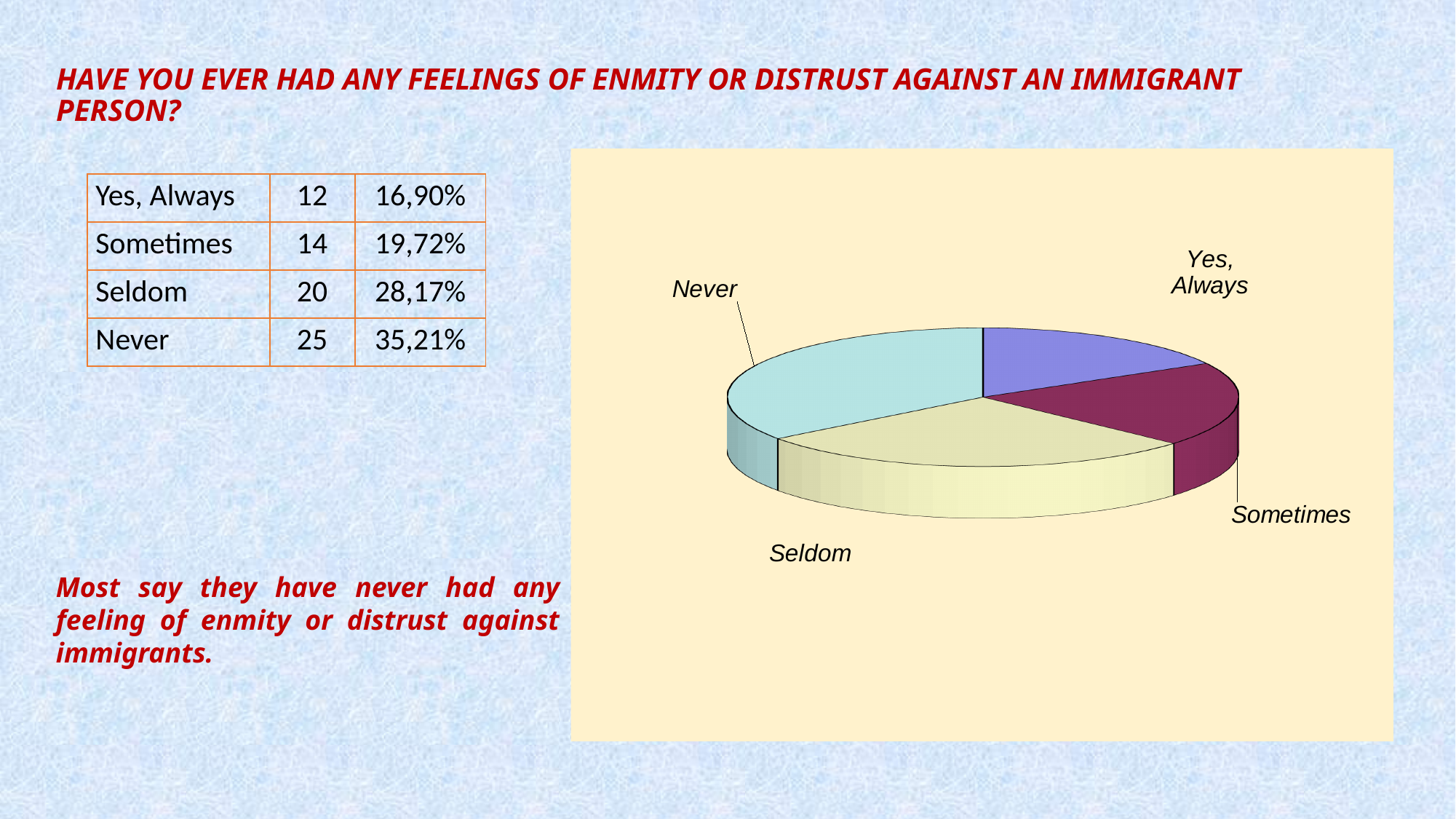
What share of the pie does the Sometimes slice represent? 19,72% What share of the pie does the Seldom slice represent? 28,17% What share of the pie does the Never slice represent? 35,21% What kind of chart is shown on the slide? pie chart Which category has the largest slice of the pie chart? Never How many respondents answered Never? 25 Which category has the smallest slice of the pie chart? Yes, Always Which slice is larger, Seldom or Sometimes? Seldom How many slices does the pie chart have? 4 How many respondents answered Seldom? 20 What is the difference in respondent count between Never and Yes, Always? 13